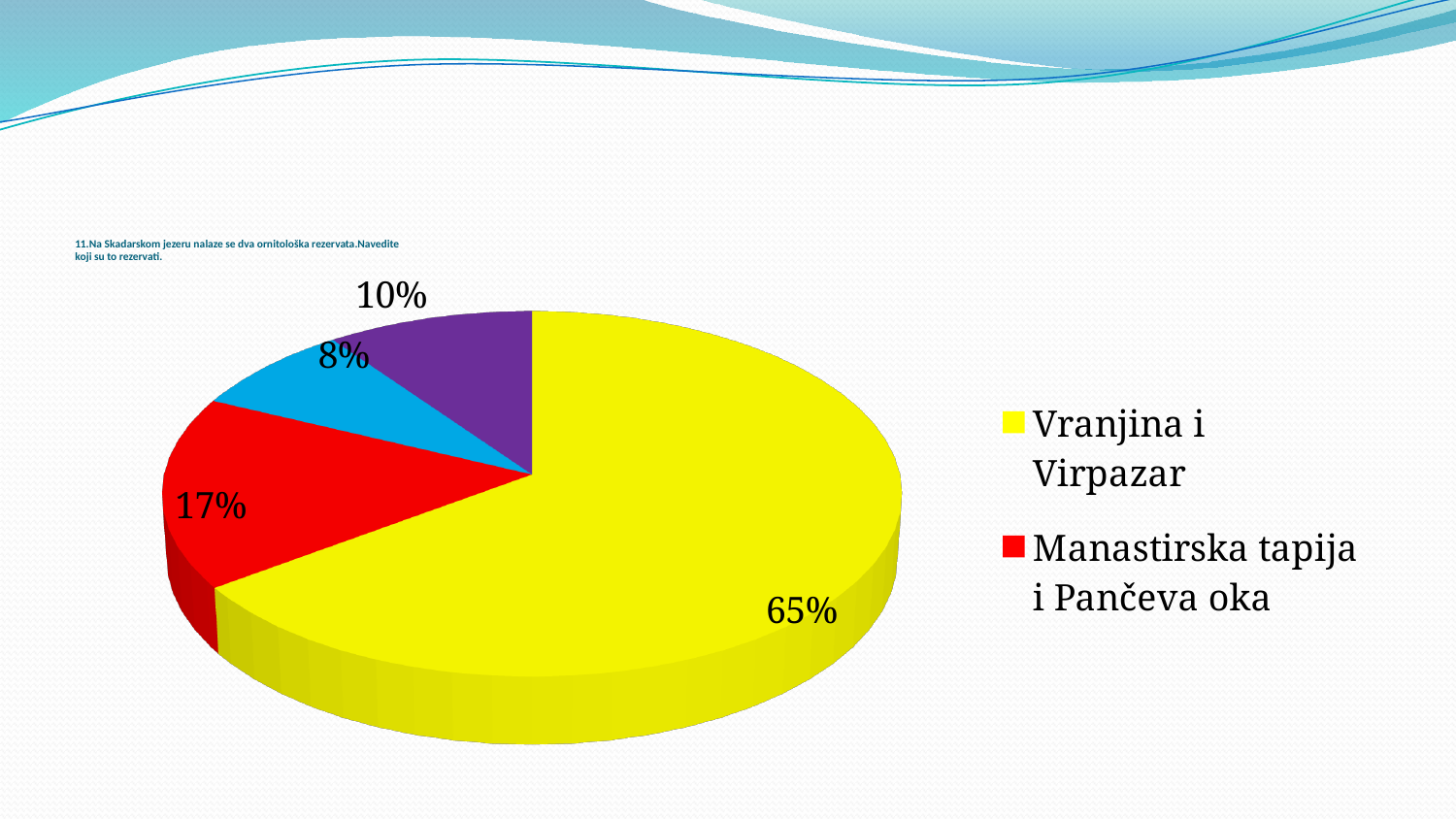
What percentage of the pie chart is the slice for Manastirska tapija i Pančeva oka? 17% What is the percentage shown on the largest slice of the pie chart? 65% What is the percentage shown on the smallest slice of the pie chart? 8% What colour is the slice for Manastirska tapija i Pančeva oka in the pie chart? Red Which legend category has the largest slice in the pie chart? Vranjina i Virpazar What percentage of the pie chart is the slice for Vranjina i Virpazar? 65% By how many percentage points is the Vranjina i Virpazar slice larger than the Manastirska tapija i Pančeva oka slice? 48 What percentage is shown on the purple slice of the pie chart? 10% What kind of chart is shown on the slide? Pie chart How many entries does the legend of the pie chart list? 2 Which is larger: the slice for Vranjina i Virpazar or the slice for Manastirska tapija i Pančeva oka? Vranjina i Virpazar How many slices does the pie chart have? 4